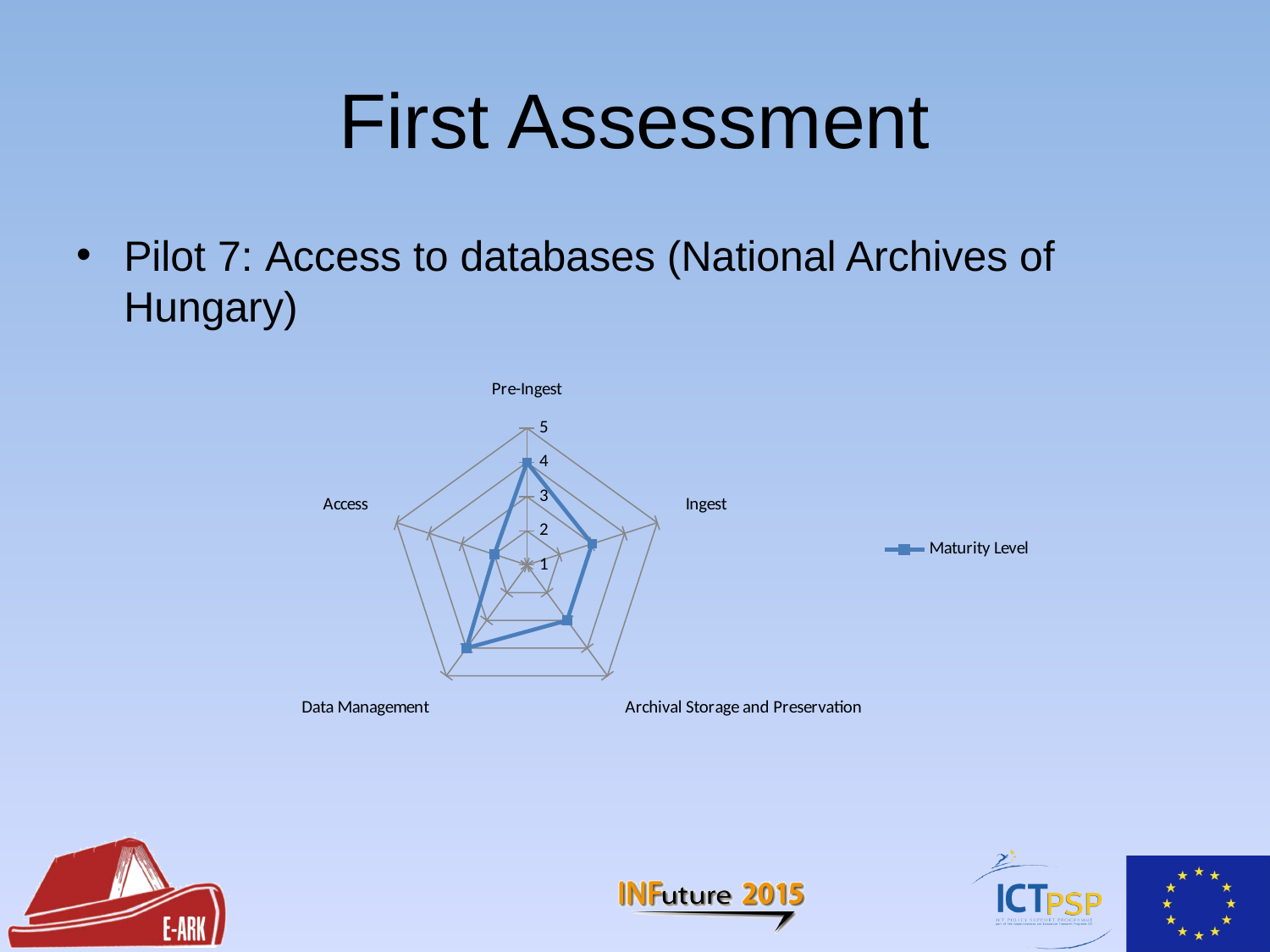
What is the maturity level for Access? 2 What is the maturity level for Pre-Ingest? 4 What is the maturity level for Ingest? 3 How many categories (axes) does the radar chart have? 5 What kind of chart is shown on the slide? radar chart What is the highest value shown on the chart's scale? 5 What is the difference between the maturity level for Data Management and for Access? 2 What is the maturity level for Data Management? 4 Which category has the lowest maturity level? Access How many series does the legend list? 1 What is the name of the series shown in the legend? Maturity Level Which is higher, the maturity level for Pre-Ingest or for Ingest? Pre-Ingest